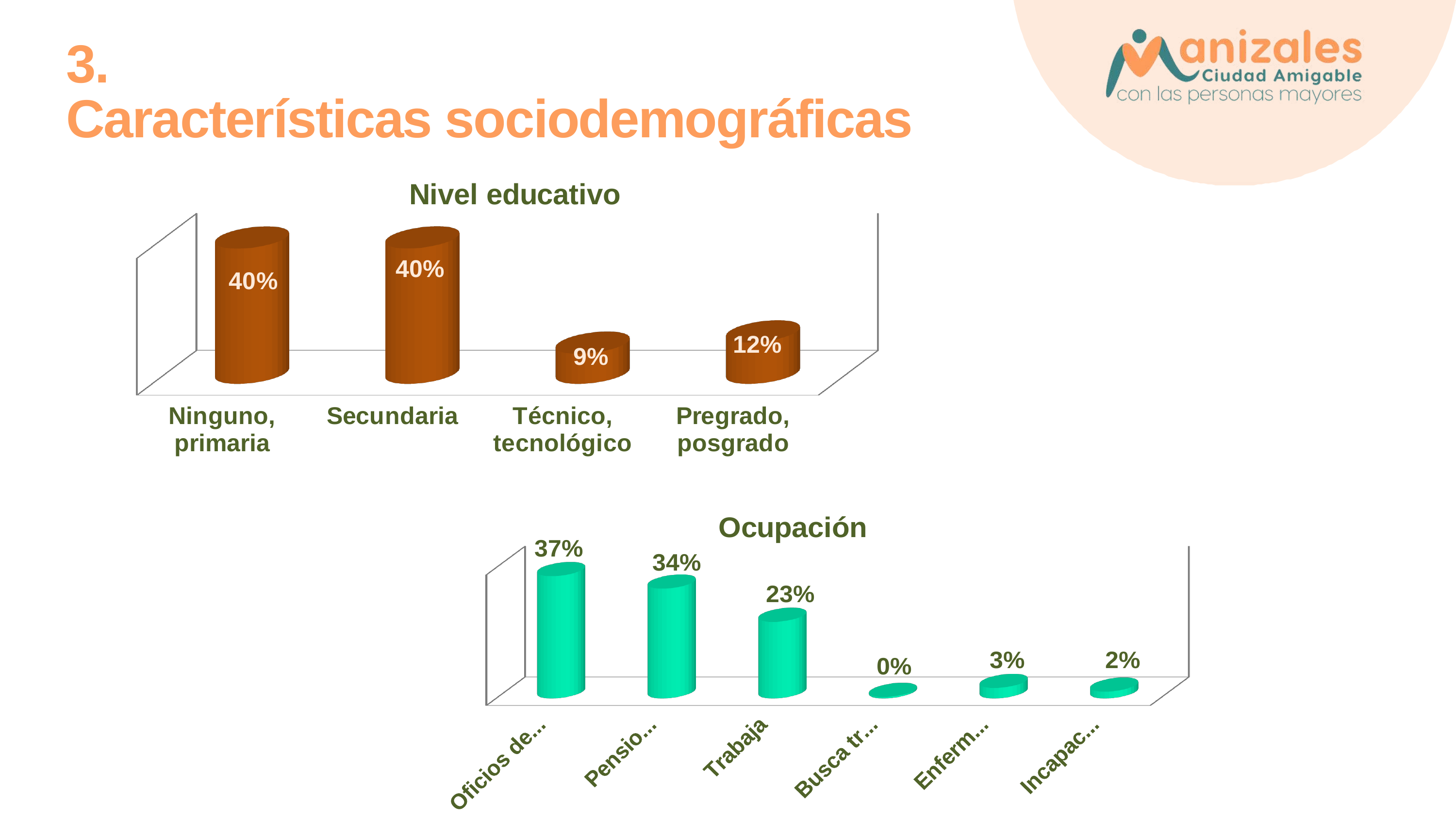
In the Ocupación chart, what is the lowest value shown? 0% How many categories does the Ocupación chart show? 6 In the Ocupación chart, what is the value for Trabaja? 23% In the Nivel educativo chart, what is the value for Técnico, tecnológico? 9% In the Nivel educativo chart, which category has the lowest value? Técnico, tecnológico How many categories does the Nivel educativo chart show? 4 In the Nivel educativo chart, what is the value for Secundaria? 40% In the Ocupación chart, what is the highest value shown? 37% In the Nivel educativo chart, what is the value for Pregrado, posgrado? 12% In the Nivel educativo chart, which is larger: Ninguno, primaria or Pregrado, posgrado? Ninguno, primaria In the Nivel educativo chart, what is the difference between Pregrado, posgrado and Técnico, tecnológico? 3% What type of chart is the Ocupación chart? Bar chart